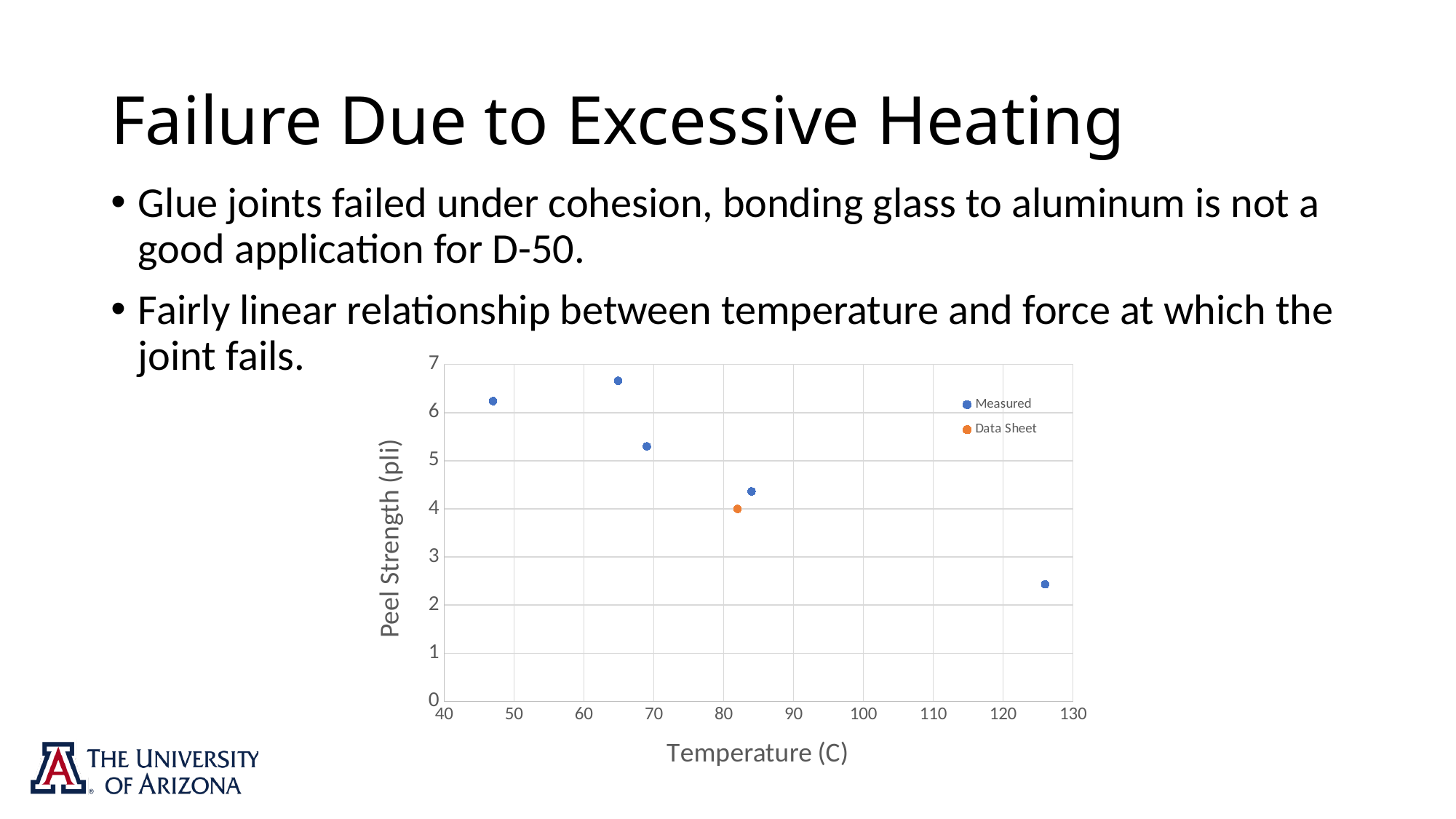
Is the peel strength of the Measured point at the highest temperature (around 126 C) greater or less than 3? less Does the peel strength of the Measured points generally rise or fall as temperature increases? fall Is the peel strength of the Measured point near 84 C greater or less than the Data Sheet point? greater How many Data Sheet (orange) points are plotted on the chart? 1 How many series does the chart legend list? 2 Which Measured point has the lowest peel strength: the one near 47 C or the one near 126 C? the one near 126 C What is the label of the chart's y axis? Peel Strength (pli) What are the two series named in the chart legend? Measured and Data Sheet Is the peel strength of the Measured point near 65 C greater or less than 6? greater How many Measured (blue) points are plotted on the chart? 5 What kind of chart is shown on the slide? scatter chart Is the peel strength of the Data Sheet point greater or less than 5? less